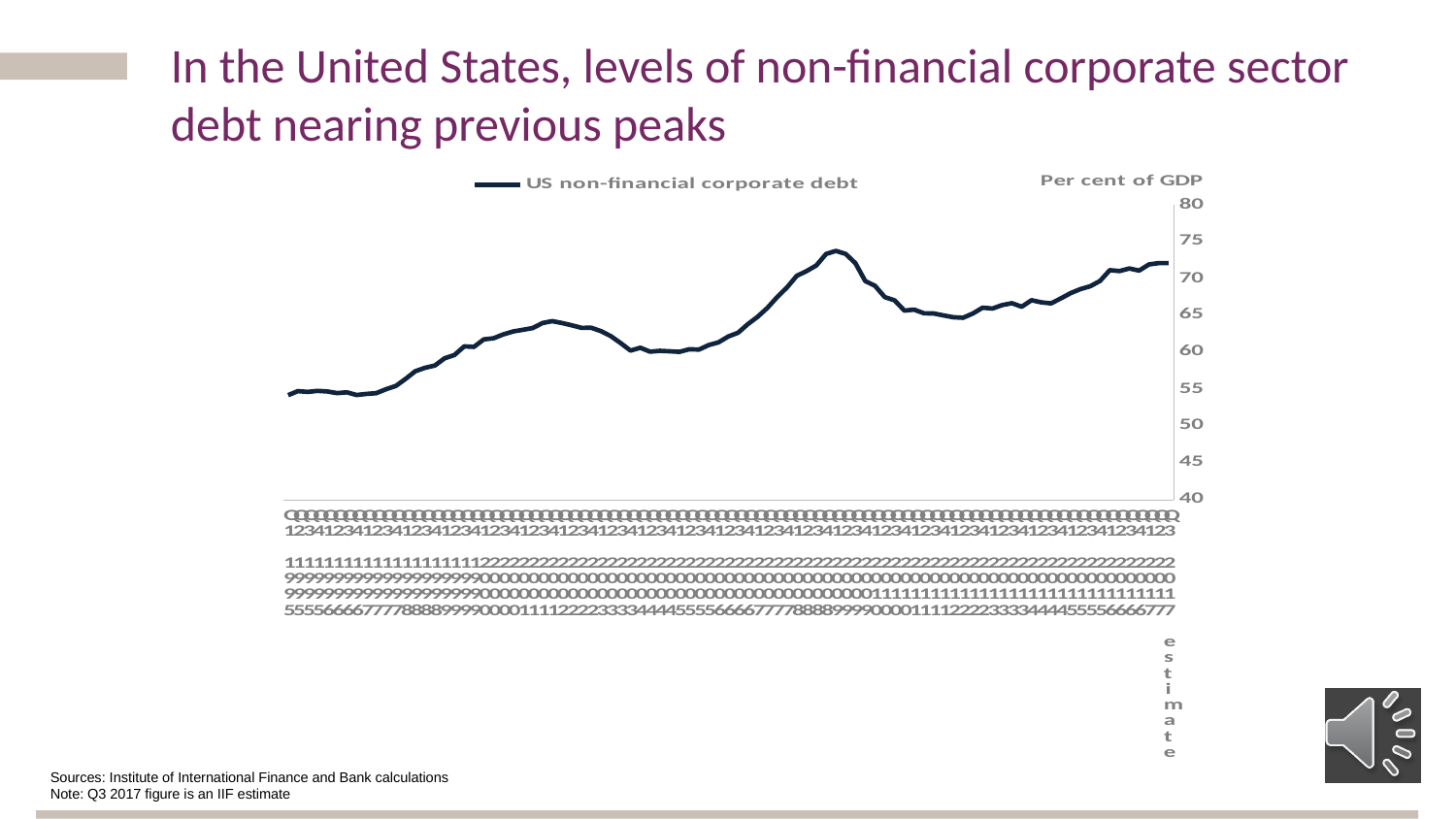
What is the name of the series shown in the legend? US non-financial corporate debt Is the peak value of US non-financial corporate debt reached around 2008-2009 greater or less than 75? less Between the peak around 2008-2009 and around 2011, does US non-financial corporate debt rise or fall? fall Is the value of US non-financial corporate debt around 2011 greater or less than 70? less Is the value of US non-financial corporate debt at its low point around 2004-2005 greater or less than 65? less What kind of chart is shown on the slide? line chart How many series does the legend list? 1 What unit is shown on the vertical axis of the chart? Per cent of GDP Overall, does US non-financial corporate debt as a per cent of GDP rise or fall from the start of the series in 1995 to the end in 2017? rise